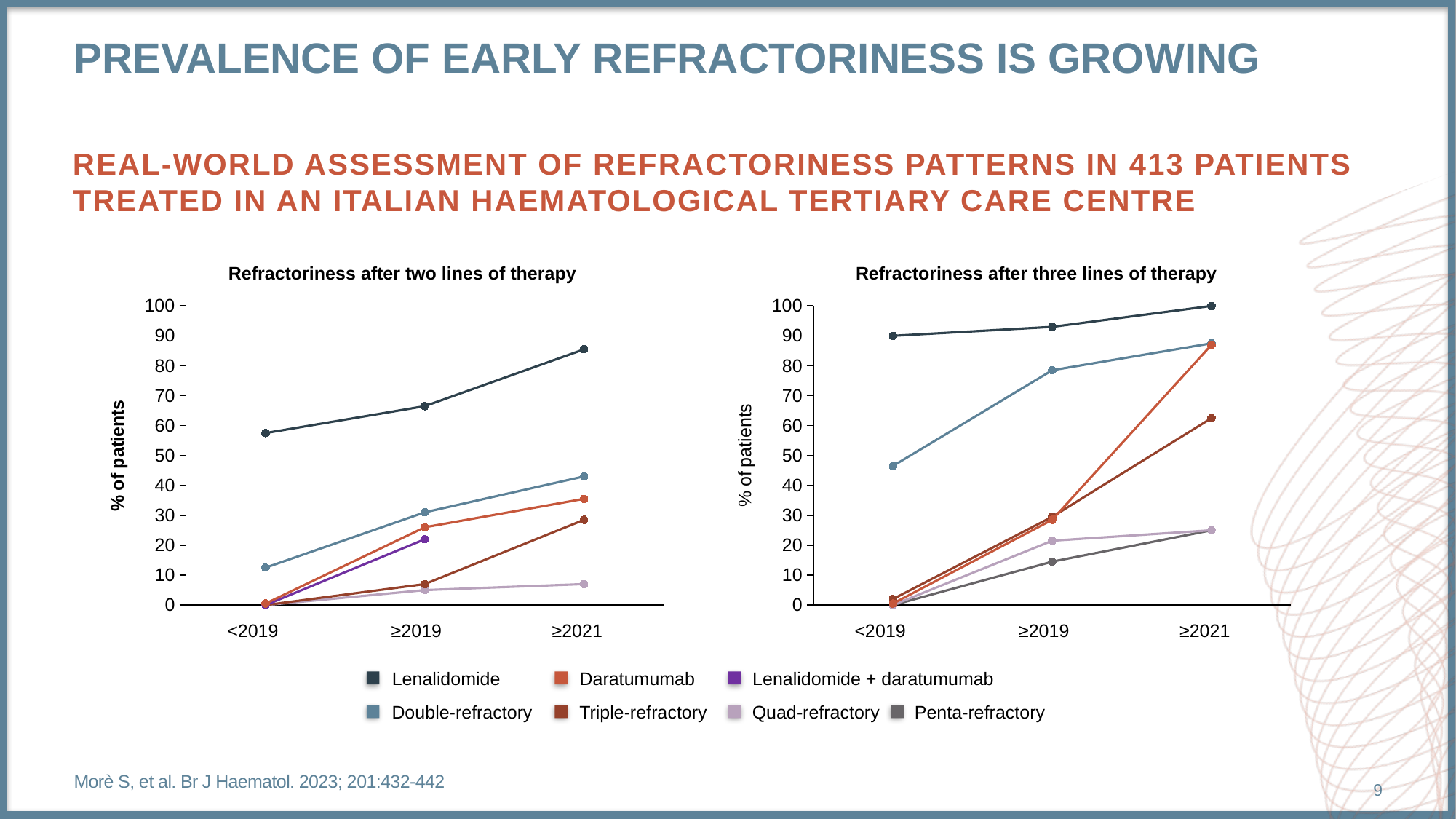
In 'Refractoriness after two lines of therapy', which series has the lowest value at ≥2021? Quad-refractory In 'Refractoriness after two lines of therapy', which series has the highest value at ≥2021? Lenalidomide In 'Refractoriness after two lines of therapy', does the Lenalidomide series rise or fall from <2019 to ≥2021? rise In 'Refractoriness after three lines of therapy', is the value for Double-refractory at <2019 greater or less than 50? less How many time-period categories are on the x axis of 'Refractoriness after three lines of therapy'? 3 What is the title of the right chart? Refractoriness after three lines of therapy In 'Refractoriness after three lines of therapy', what is the value for Lenalidomide at ≥2021? 100 In 'Refractoriness after two lines of therapy', is the value for Lenalidomide at ≥2021 greater or less than 80? greater What is the y-axis label of the left chart? % of patients How many series does the shared legend list? 7 What kind of chart is 'Refractoriness after two lines of therapy'? line chart In 'Refractoriness after three lines of therapy', which is larger at ≥2019: Double-refractory or Triple-refractory? Double-refractory